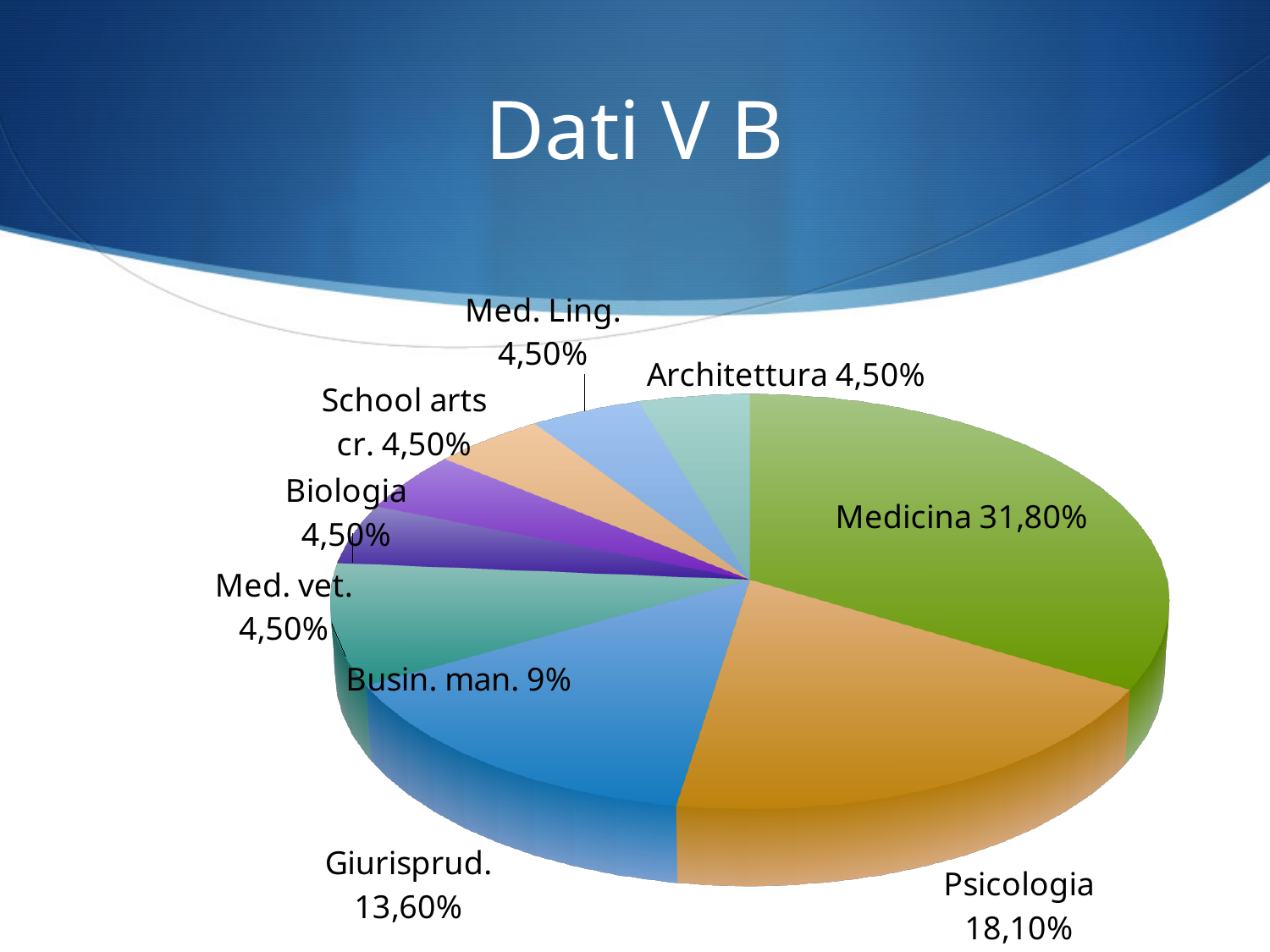
What percentage is shown for Architettura? 4,50% What percentage is shown for Psicologia? 18,10% What percentage is shown for Giurisprud.? 13,60% Which is larger, Giurisprud. or Busin. man.? Giurisprud. What kind of chart is shown on the slide? pie chart What percentage is shown for Medicina? 31,80% Which category has the largest slice of the pie? Medicina How many categories are labelled with 4,50%? 5 What is the difference in percentage points between Medicina and Psicologia? 13,70 What is the title of the slide? Dati V B What percentage is shown for Busin. man.? 9% How many slices does the pie chart have? 9